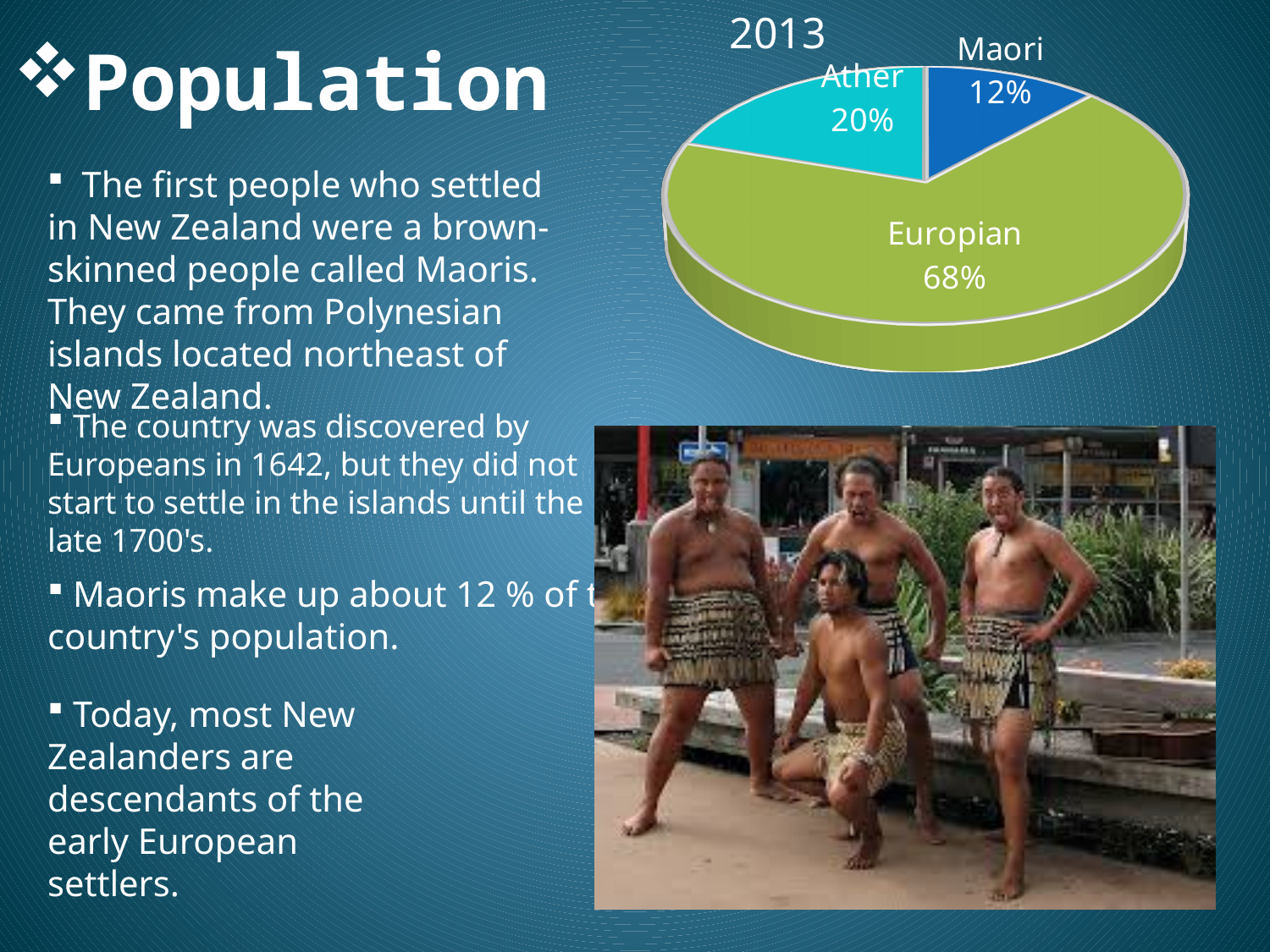
Which slice of the pie chart is the smallest? Maori Which is larger, the Ather slice or the Maori slice? Ather Which slice of the pie chart is the largest? Europian What is the title of the pie chart? 2013 How many slices does the pie chart have? 3 What share of the pie chart does the Maori slice represent? 12% What share of the pie chart does the Ather slice represent? 20% What colour is the Europian slice of the pie chart? Green What share of the pie chart does the Europian slice represent? 68% What kind of chart is shown on the slide? Pie chart What is the difference in percentage points between the Europian and Maori slices? 56 What is the difference in percentage points between the Ather and Maori slices? 8